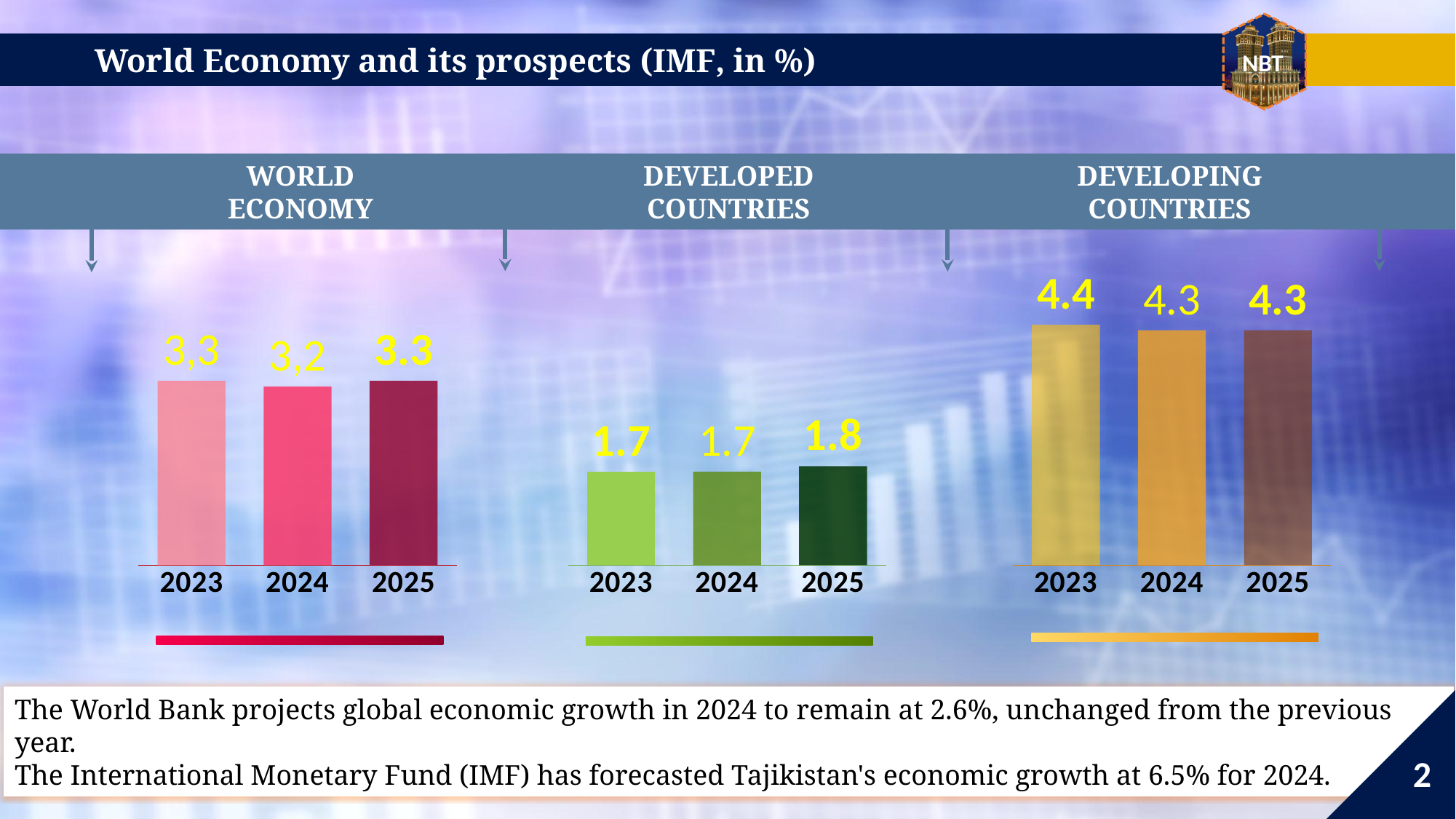
In the Developing Countries chart, what is the difference between the 2023 value and the 2024 value? 0.1 In the World Economy chart, what is the value for 2024? 3,2 In the World Economy chart, what is the value for 2025? 3.3 In the World Economy chart, which year has the lowest value? 2024 How many bars are in the Developed Countries chart? 3 In the Developed Countries chart, is the value for 2023 or 2025 larger? 2025 In the Developed Countries chart, what is the value for 2025? 1.8 In the Developing Countries chart, what is the value for 2023? 4.4 What kind of chart is the World Economy chart? Bar chart How many separate charts are shown on the slide? 3 In the Developed Countries chart, which year has the highest value? 2025 In the Developing Countries chart, which year has the highest value? 2023